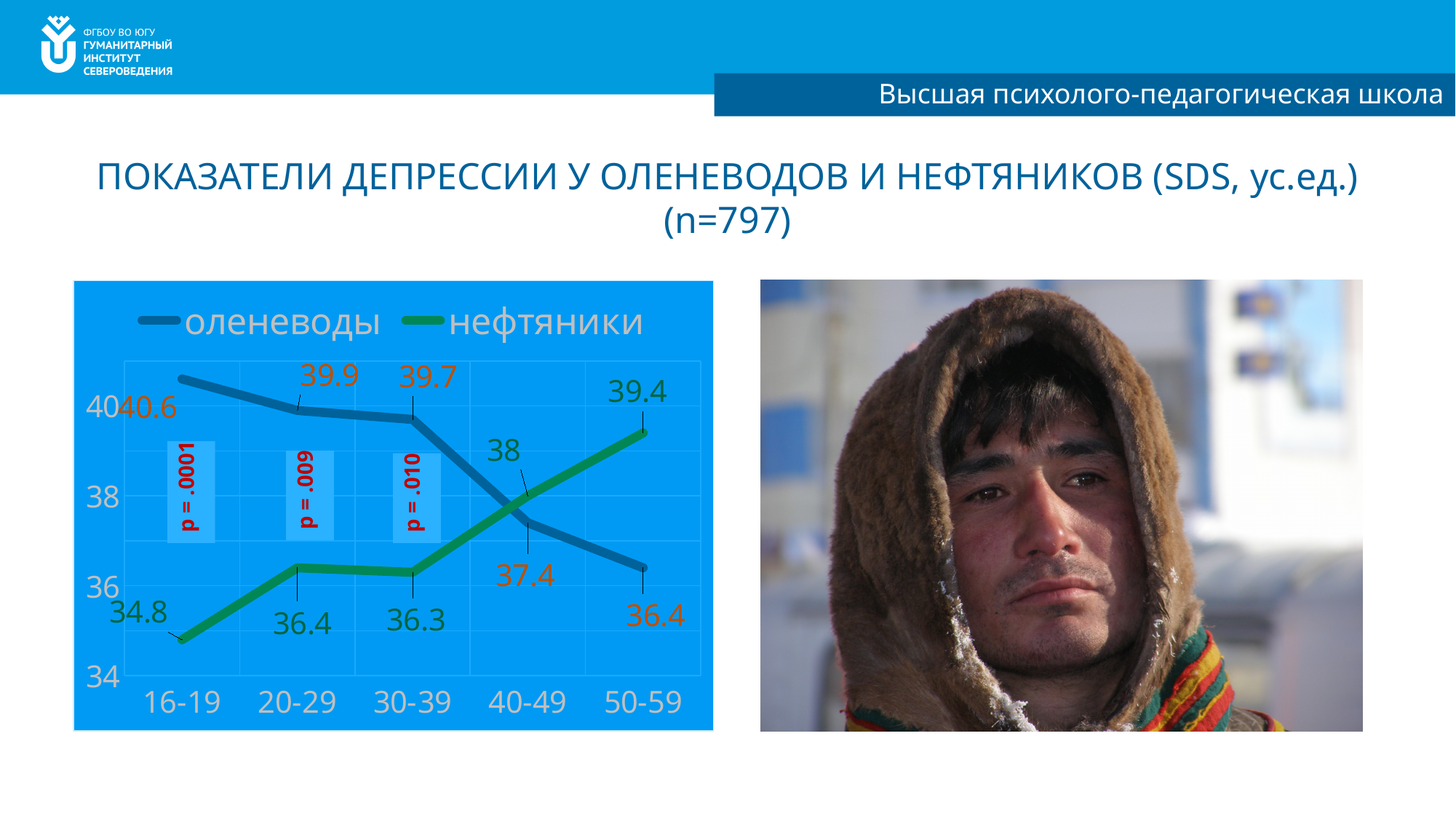
How many age groups are shown on the x axis? 5 What is the difference between оленеводы and нефтяники in the 16-19 age group? 5.8 Which series has the larger value in the 50-59 age group, оленеводы or нефтяники? нефтяники What is the value for оленеводы in the 40-49 age group? 37.4 In which age group is the value for нефтяники lowest? 16-19 How many series does the legend list? 2 What is the value for нефтяники in the 50-59 age group? 39.4 In which age group is the value for оленеводы highest? 16-19 What is the value for нефтяники in the 40-49 age group? 38 What is the value for оленеводы in the 16-19 age group? 40.6 What kind of chart is shown on the slide? line chart Do the values for оленеводы rise or fall from the 16-19 group to the 50-59 group? fall